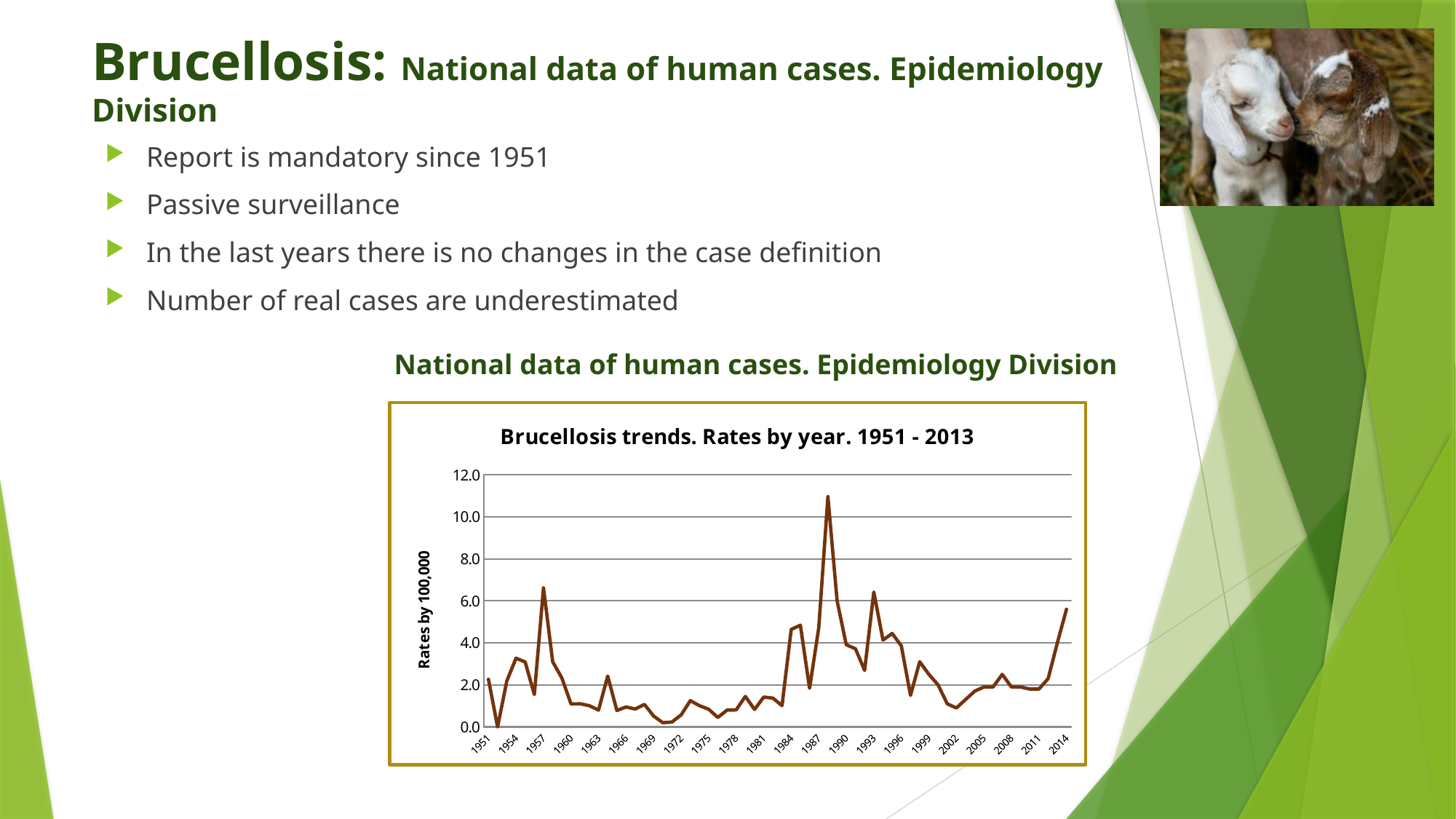
Is the value for 1969 greater or less than 1.0? less Is the value for 1957 greater or less than 5.0? greater What is the title of the chart? Brucellosis trends. Rates by year. 1951 - 2013 Is the value for 1951 greater or less than 4.0? less Do the values rise or fall between 1957 and 1960? fall What kind of chart is shown on the slide? line chart Do the values rise or fall between 2011 and 2014? rise Which is larger, the value for 1951 or the value for 1969? 1951 What is the label of the vertical axis of the chart? Rates by 100,000 How many year labels are shown on the horizontal axis? 22